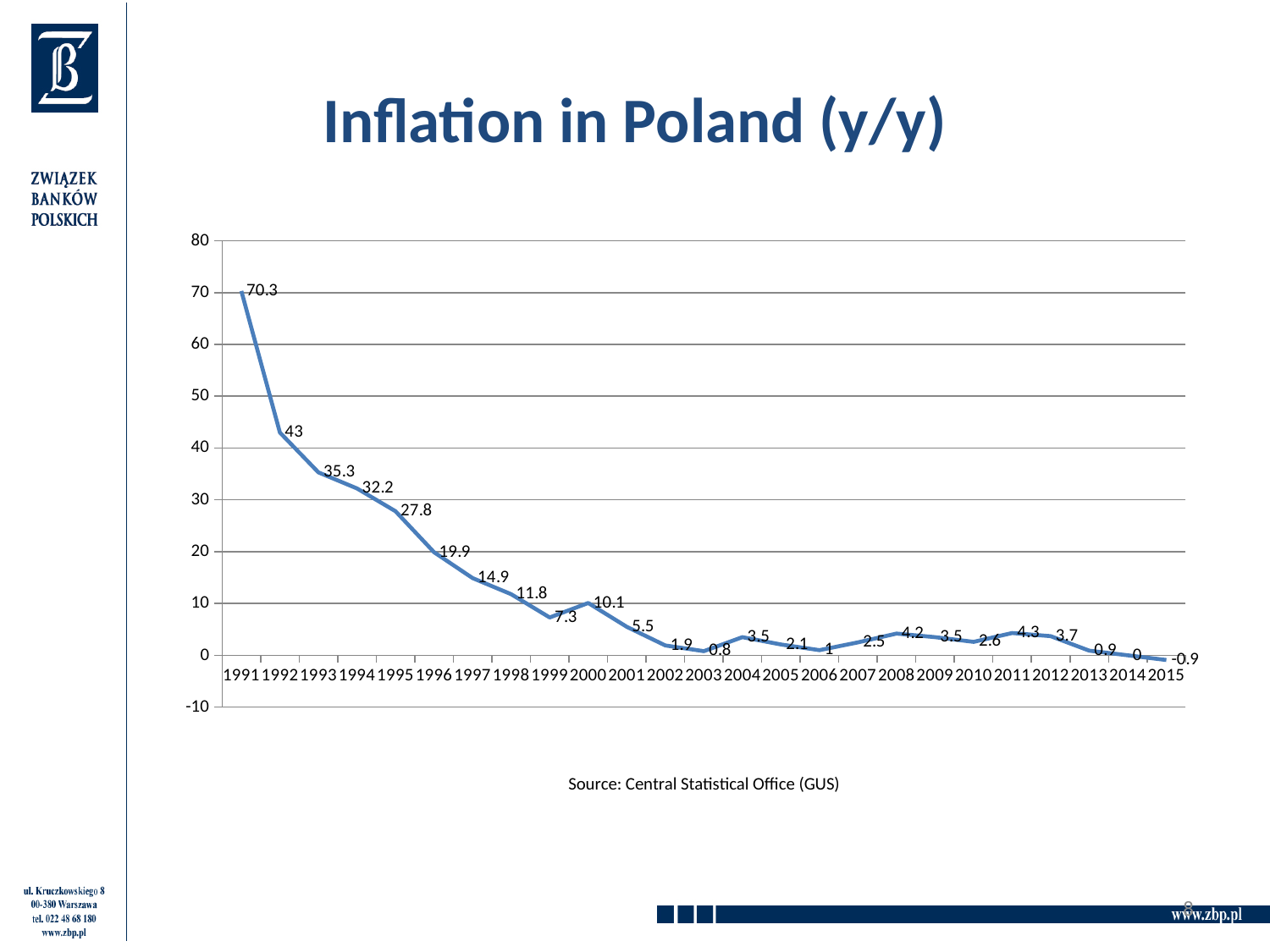
What is the inflation value for 1991? 70.3 What is the inflation value for 2000? 10.1 What is the title of the chart? Inflation in Poland (y/y) What is the inflation value for 2015? -0.9 How many years are plotted on the chart? 25 Which year has the larger inflation value, 1999 or 2000? 2000 What type of chart is shown on the slide? Line chart Does inflation generally rise or fall from 1991 to 1999? Fall What is the difference between the inflation values for 1991 and 1992? 27.3 Which year has the highest inflation value? 1991 Which year has the lowest inflation value? 2015 What is the inflation value for 2008? 4.2